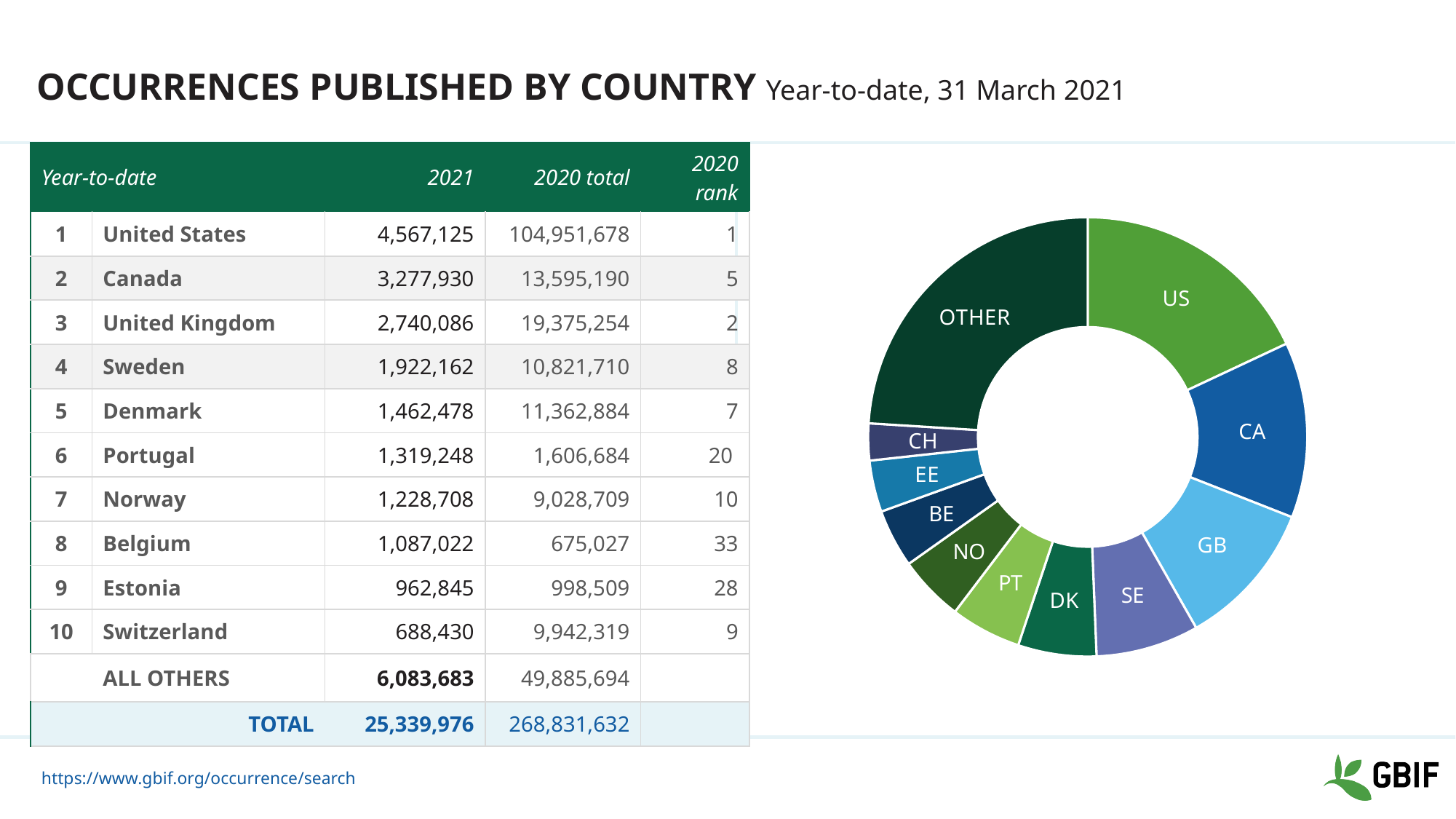
What is the 2021 year-to-date value for the US slice of the donut chart? 4,567,125 What is the total of all slices in the donut chart (2021 year-to-date)? 25,339,976 What is the 2021 year-to-date value for the SE slice of the donut chart? 1,922,162 Which slice of the donut chart is the largest? OTHER Which slice of the donut chart is labelled with the darkest green colour? OTHER How many slices does the donut chart have? 11 Which labelled slice of the donut chart is the smallest? CH What kind of chart is shown on the right of the slide? Donut (pie) chart Which slice is larger in the donut chart, CA or GB? CA What is the 2021 year-to-date value represented by the OTHER slice of the donut chart? 6,083,683 What is the difference between the US and CA values shown in the donut chart (2021 year-to-date)? 1,289,195 Which slice is larger in the donut chart, US or CA? US